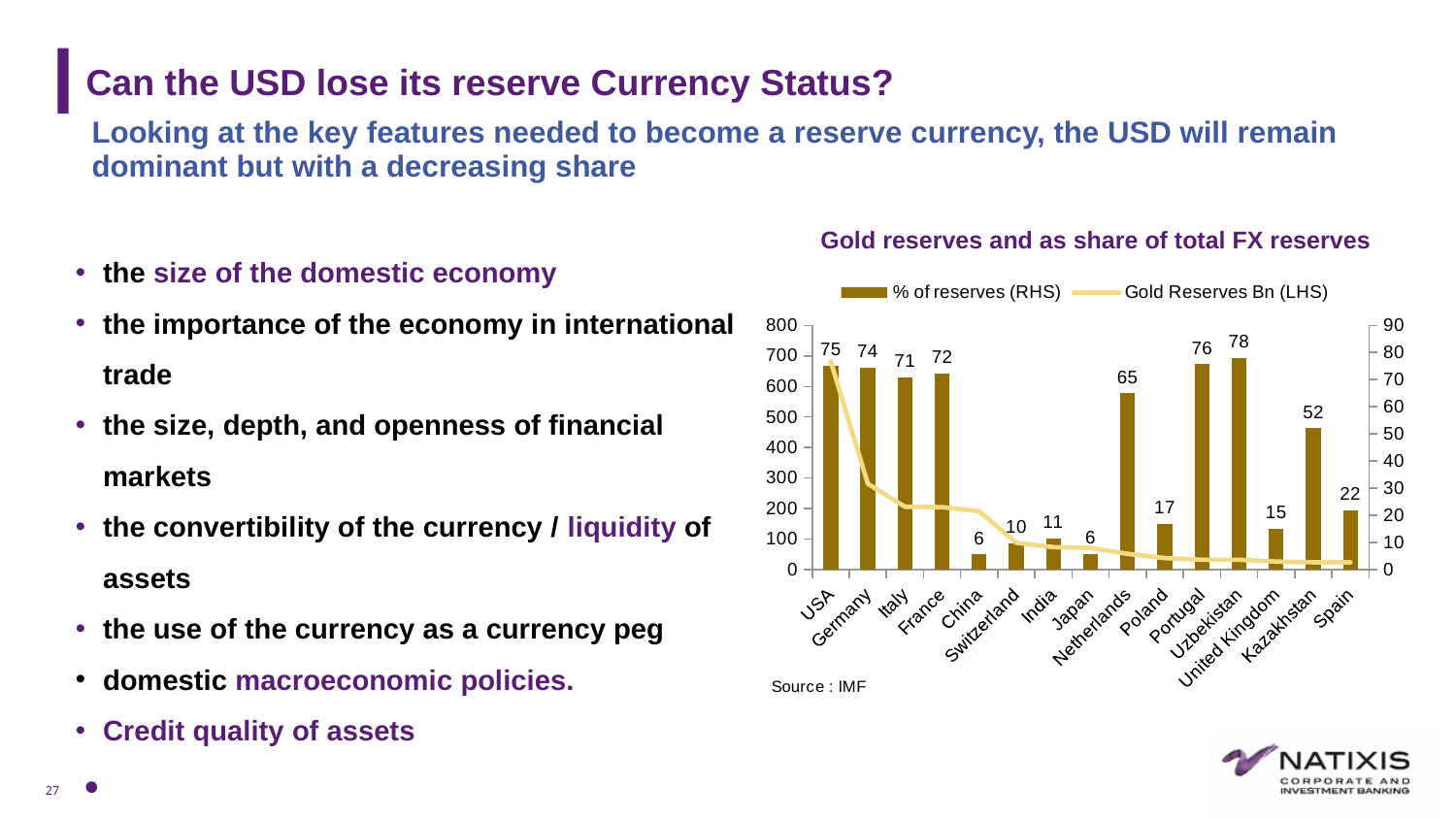
Which has a larger % of reserves value, Germany or Kazakhstan? Germany What is the % of reserves value for Uzbekistan? 78 What is the difference in % of reserves between USA and Spain? 53 What is the % of reserves value for Kazakhstan? 52 Is the Gold Reserves Bn (LHS) value for USA greater or less than 500? greater How many countries are shown on the x axis of the chart? 15 What type of chart is used for the % of reserves (RHS) series? bar chart What is the % of reserves value for Netherlands? 65 How many series does the chart legend list? 2 Which country has the highest % of reserves bar? Uzbekistan What is the title of the chart? Gold reserves and as share of total FX reserves What is the difference in % of reserves between Portugal and Poland? 59